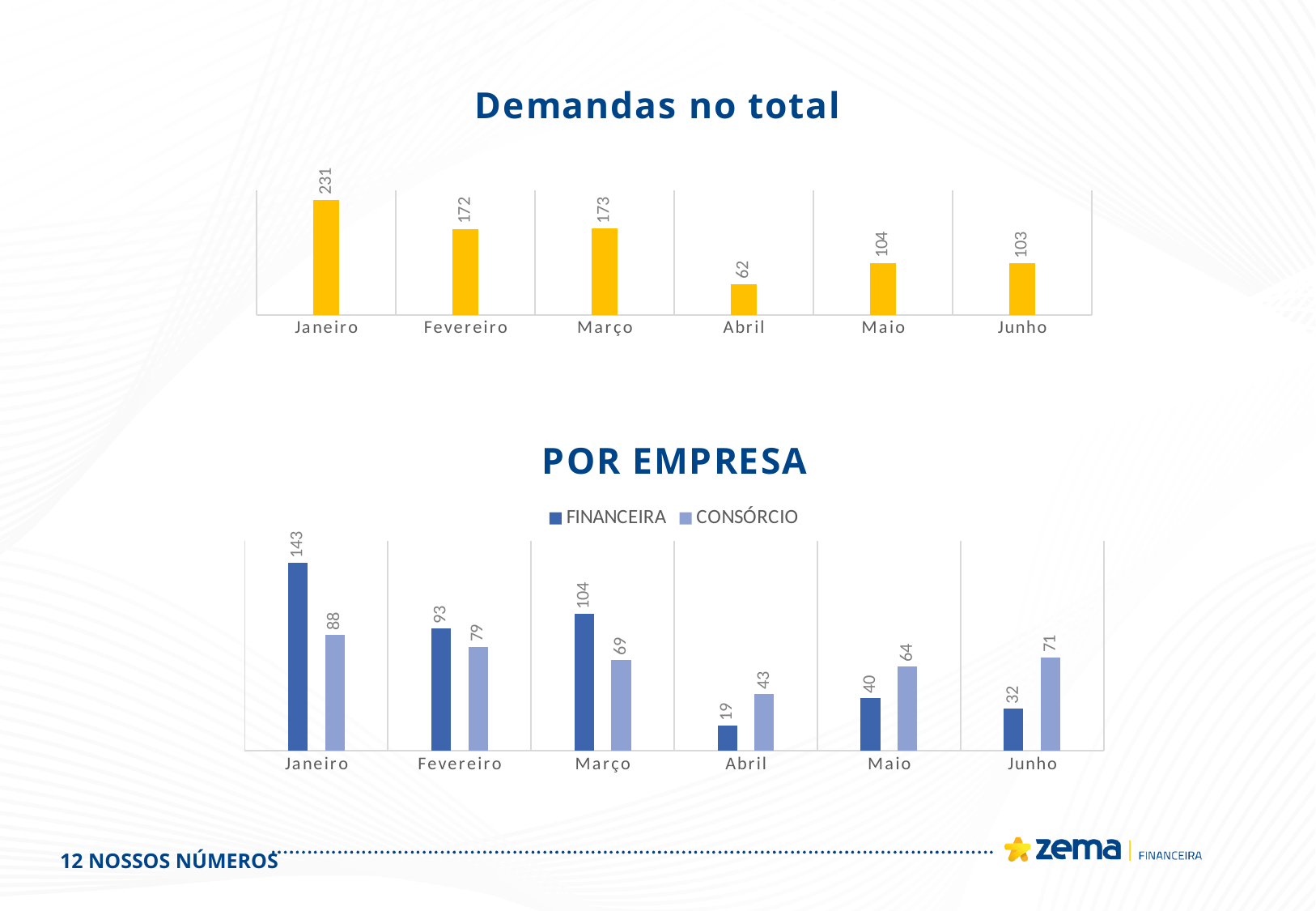
In the 'Demandas no total' chart, which month has the lowest value? Abril In the 'POR EMPRESA' chart, what is the difference between FINANCEIRA and CONSÓRCIO for Janeiro? 55 How many series does the legend of the 'POR EMPRESA' chart list? 2 In the 'Demandas no total' chart, how many months are shown? 6 In the 'POR EMPRESA' chart, which is larger for Maio: FINANCEIRA or CONSÓRCIO? CONSÓRCIO In the 'Demandas no total' chart, what is the difference between Janeiro and Abril? 169 In the 'Demandas no total' chart, what is the value for Janeiro? 231 In the 'POR EMPRESA' chart, which series is shown in the darker blue colour? FINANCEIRA In the 'POR EMPRESA' chart, which month has the highest FINANCEIRA value? Janeiro What kind of chart is the 'Demandas no total' chart? Bar chart In the 'POR EMPRESA' chart, what is the CONSÓRCIO value for Junho? 71 In the 'POR EMPRESA' chart, what is the FINANCEIRA value for Março? 104